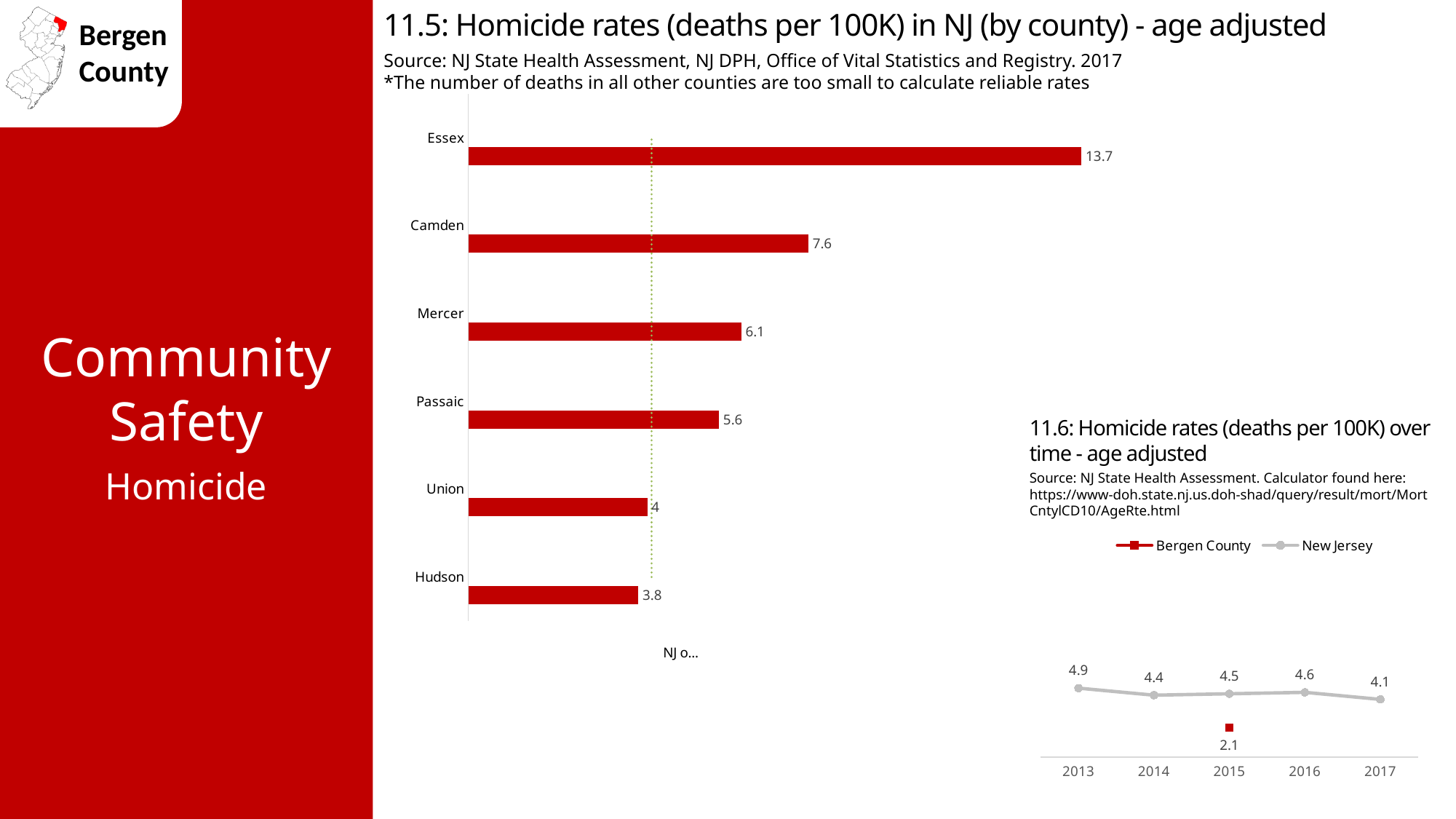
In chart 11.5 (Homicide rates in NJ by county), which county has the highest homicide rate? Essex In chart 11.6 (Homicide rates over time), what is the Bergen County homicide rate in 2015? 2.1 In chart 11.6 (Homicide rates over time), how many series does the legend list? 2 In chart 11.5 (Homicide rates in NJ by county), what is the difference between the rates for Camden and Mercer? 1.5 In chart 11.5 (Homicide rates in NJ by county), which county has the lowest homicide rate? Hudson What kind of chart is chart 11.5 (Homicide rates in NJ by county)? Bar chart In chart 11.6 (Homicide rates over time), what is the difference between the New Jersey rates in 2013 and 2017? 0.8 In chart 11.5 (Homicide rates in NJ by county), what is the homicide rate for Essex? 13.7 In chart 11.5 (Homicide rates in NJ by county), how many counties are shown? 6 In chart 11.5 (Homicide rates in NJ by county), which has a higher homicide rate, Union or Hudson? Union In chart 11.5 (Homicide rates in NJ by county), what is the homicide rate for Passaic? 5.6 In chart 11.6 (Homicide rates over time), what is the New Jersey homicide rate in 2013? 4.9